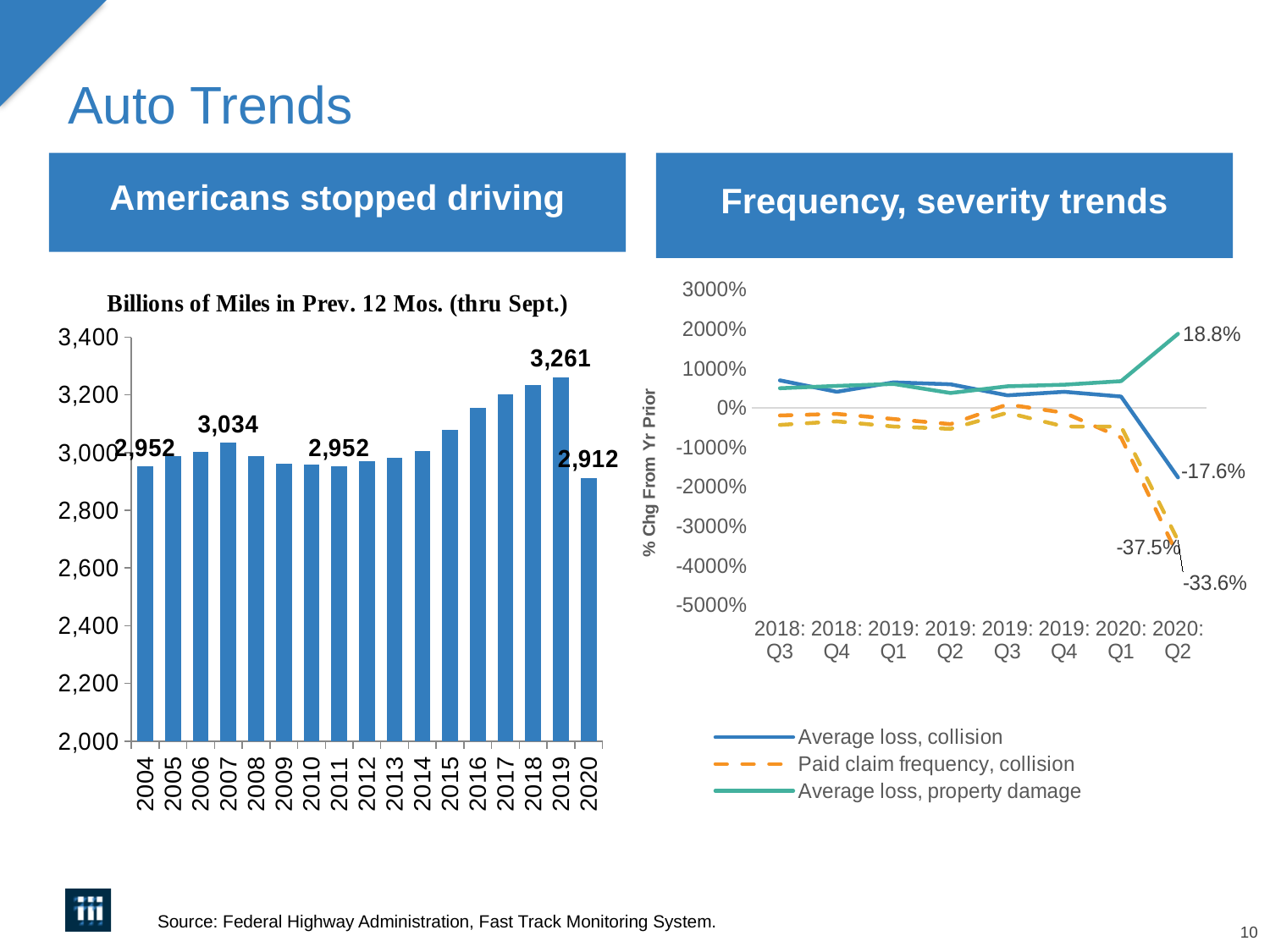
In the 'Billions of Miles in Prev. 12 Mos. (thru Sept.)' chart, is the value for 2016 greater or less than 3,000? greater In the 'Billions of Miles in Prev. 12 Mos. (thru Sept.)' chart, what is the value for 2020? 2,912 In the 'Billions of Miles in Prev. 12 Mos. (thru Sept.)' chart, which is larger, the value for 2007 or the value for 2010? 2007 In the 'Billions of Miles in Prev. 12 Mos. (thru Sept.)' chart, which year has the highest value? 2019 In the 'Frequency, severity trends' chart on the right, what is the labeled value for 'Average loss, property damage' at 2020: Q2? 18.8% In the 'Frequency, severity trends' chart on the right, what is the labeled value for 'Average loss, collision' at 2020: Q2? -17.6% In the 'Billions of Miles in Prev. 12 Mos. (thru Sept.)' chart, what is the value for 2007? 3,034 In the 'Billions of Miles in Prev. 12 Mos. (thru Sept.)' chart, what is the value for 2019? 3,261 How many years are shown in the 'Billions of Miles in Prev. 12 Mos. (thru Sept.)' chart? 17 How many series does the legend of the 'Frequency, severity trends' chart on the right list? 3 What kind of chart is the 'Billions of Miles in Prev. 12 Mos. (thru Sept.)' chart on the left? Bar chart In the 'Billions of Miles in Prev. 12 Mos. (thru Sept.)' chart, what is the difference between the 2019 and 2020 values? 349